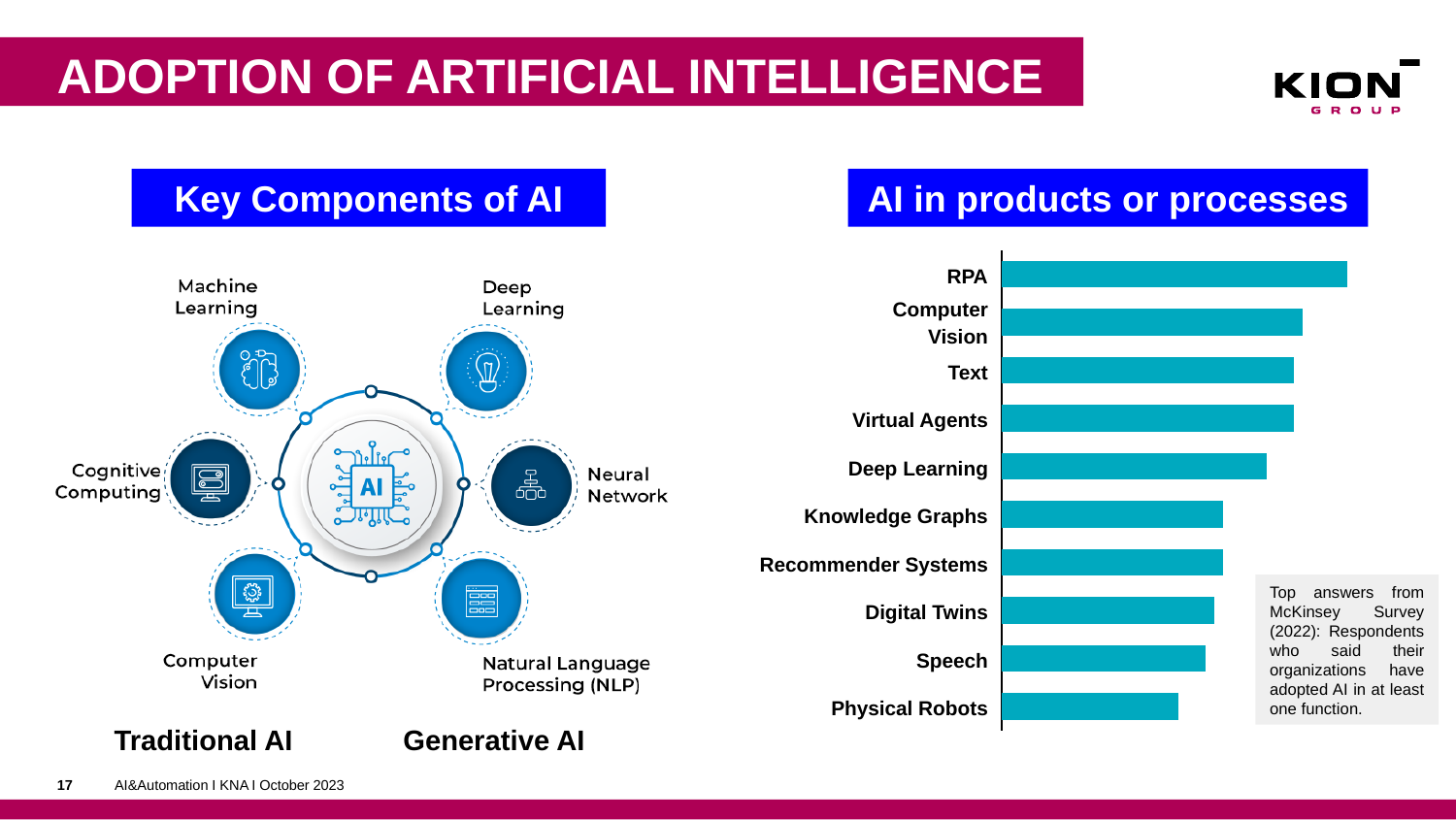
In the 'AI in products or processes' chart, which has the larger value: Computer Vision or Deep Learning? Computer Vision According to the note next to the chart, which survey is the source of the data in the 'AI in products or processes' chart? McKinsey Survey (2022) In the 'AI in products or processes' chart, which has the larger value: Speech or Physical Robots? Speech In the 'AI in products or processes' chart, which has the larger value: RPA or Digital Twins? RPA How many categories are plotted in the 'AI in products or processes' chart? 10 In the 'AI in products or processes' chart, which category has the longest bar? RPA In the 'AI in products or processes' chart, do the bar lengths generally increase or decrease from the top category to the bottom category? decrease What is the title of the chart on the right side of the slide? AI in products or processes What kind of chart is shown under the heading 'AI in products or processes'? bar chart In the 'AI in products or processes' chart, which category has the shortest bar? Physical Robots